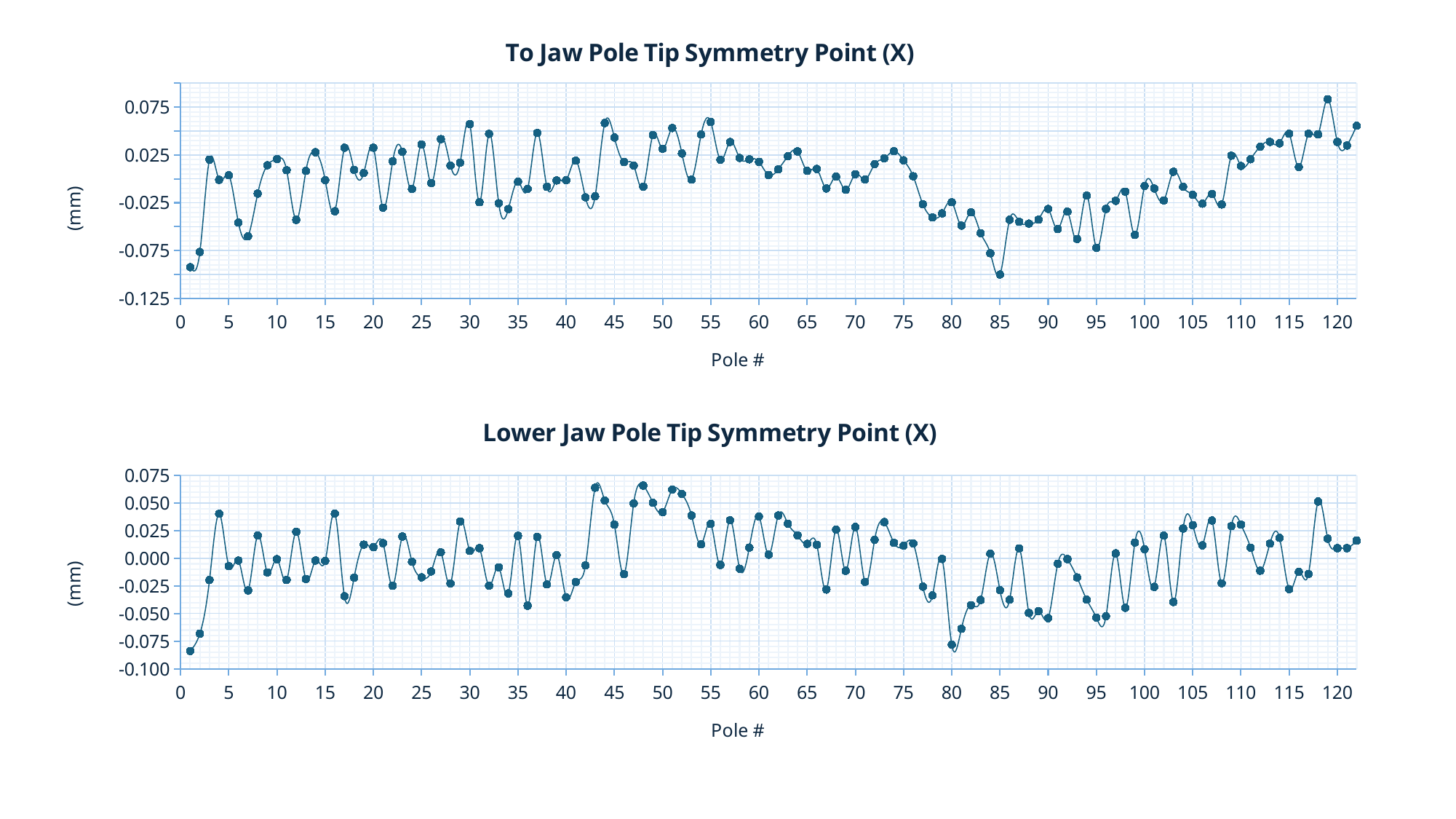
In the top chart 'To Jaw Pole Tip Symmetry Point (X)', is the value at pole 85 greater or less than -0.075? less What is the x-axis label on the top chart 'To Jaw Pole Tip Symmetry Point (X)'? Pole # In the bottom chart 'Lower Jaw Pole Tip Symmetry Point (X)', which has the larger value: pole 43 or pole 80? pole 43 In the top chart 'To Jaw Pole Tip Symmetry Point (X)', is the value at pole 1 greater or less than -0.075? less In the bottom chart 'Lower Jaw Pole Tip Symmetry Point (X)', is the value at pole 48 greater or less than 0.050? greater What is the title of the lower chart on the slide? Lower Jaw Pole Tip Symmetry Point (X) In the top chart 'To Jaw Pole Tip Symmetry Point (X)', which has the larger value: pole 119 or pole 85? pole 119 In the top chart 'To Jaw Pole Tip Symmetry Point (X)', do the values generally rise or fall from pole 75 to pole 85? fall What kind of chart is the top chart titled 'To Jaw Pole Tip Symmetry Point (X)'? line chart